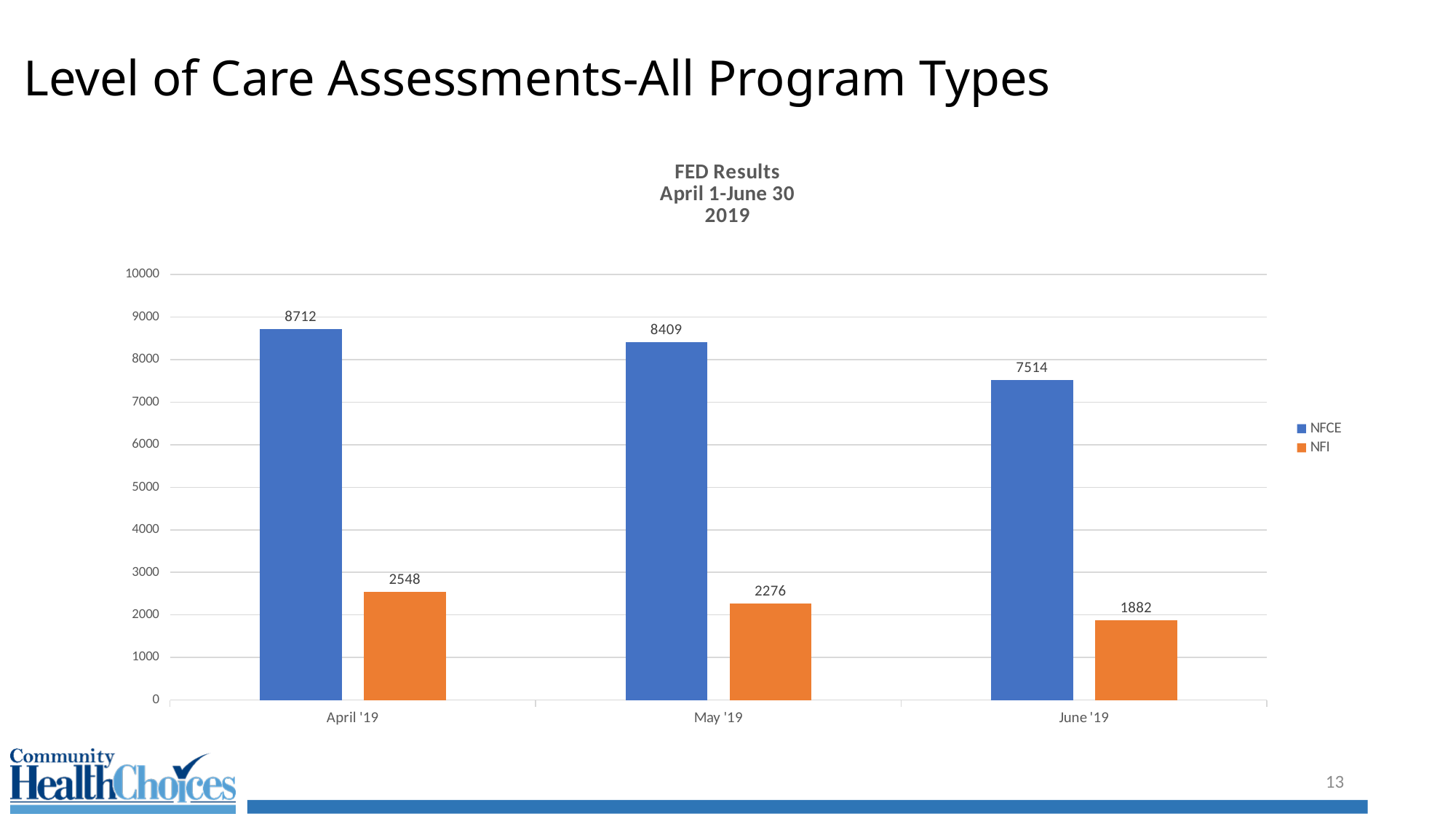
Is the NFI value for April '19 greater or less than 3000? less Which month has the lowest NFI value? June '19 What is the NFI value for May '19? 2276 What is the NFCE value for April '19? 8712 How many series does the legend list? 2 How many months are shown on the x axis? 3 What is the NFI value for June '19? 1882 What is the difference between the NFCE values for April '19 and June '19? 1198 What kind of chart is shown on the slide? bar chart Which is larger, the NFCE value for May '19 or the NFCE value for June '19? May '19 What is the difference between the NFI values for April '19 and May '19? 272 Which month has the highest NFCE value? April '19